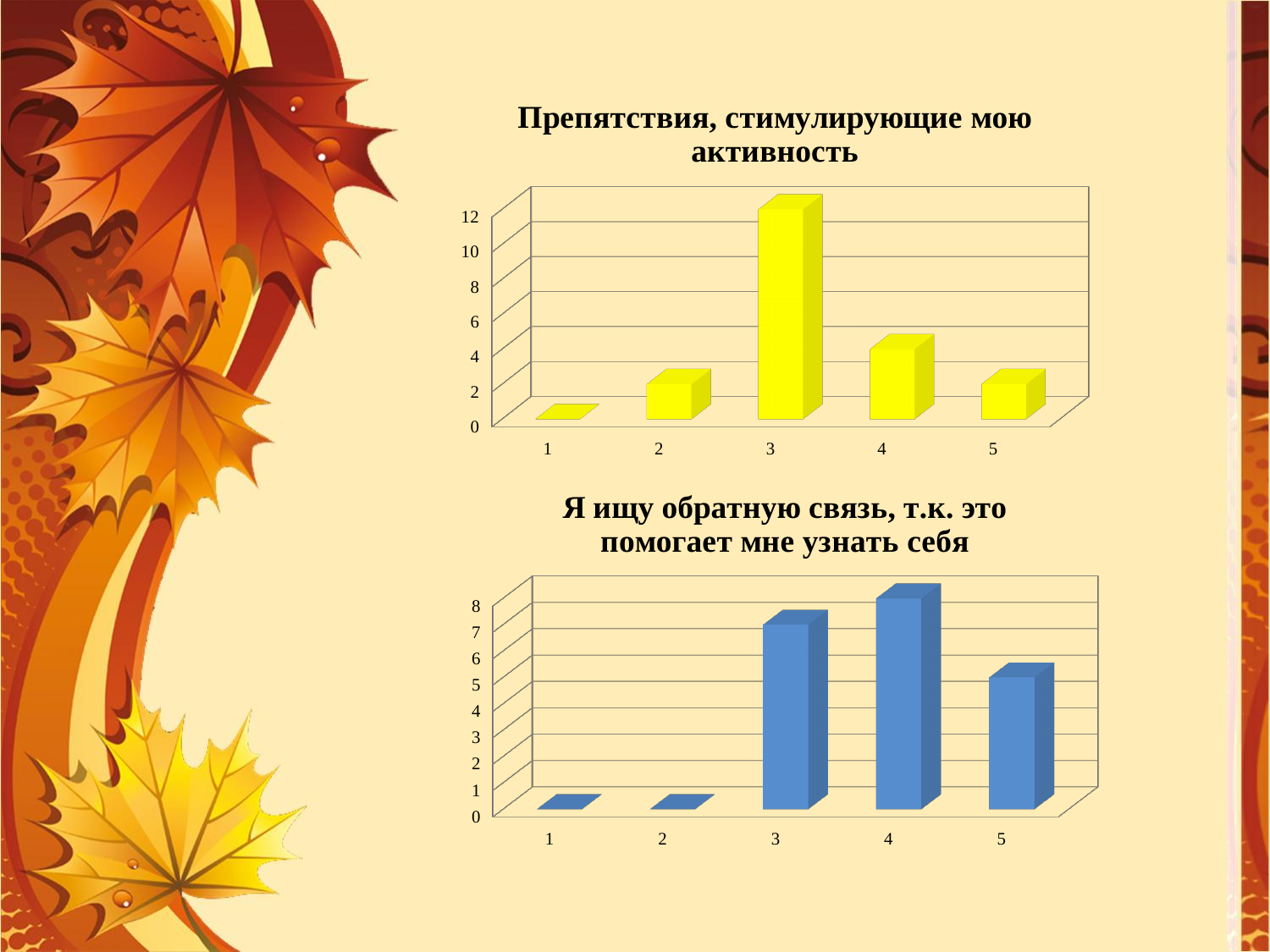
In the bottom chart ("Я ищу обратную связь, т.к. это помогает мне узнать себя"), is the value for category 3 greater or less than 6? greater In the top chart ("Препятствия, стимулирующие мою активность"), is the value for category 4 greater or less than 6? less What type of chart is shown under the title "Препятствия, стимулирующие мою активность"? bar chart In the top chart ("Препятствия, стимулирующие мою активность"), is the value for category 3 greater or less than 10? greater In the bottom chart ("Я ищу обратную связь, т.к. это помогает мне узнать себя"), which is larger, the value for category 3 or category 5? category 3 What colour are the bars in the bottom chart ("Я ищу обратную связь, т.к. это помогает мне узнать себя")? blue In the top chart ("Препятствия, стимулирующие мою активность"), which is larger, the value for category 3 or category 4? category 3 In the top chart ("Препятствия, стимулирующие мою активность"), which category has the highest bar? 3 In the top chart ("Препятствия, стимулирующие мою активность"), which category has the lowest bar? 1 In the top chart ("Препятствия, стимулирующие мою активность"), how many categories are shown on the x axis? 5 In the bottom chart ("Я ищу обратную связь, т.к. это помогает мне узнать себя"), which category has the highest bar? 4